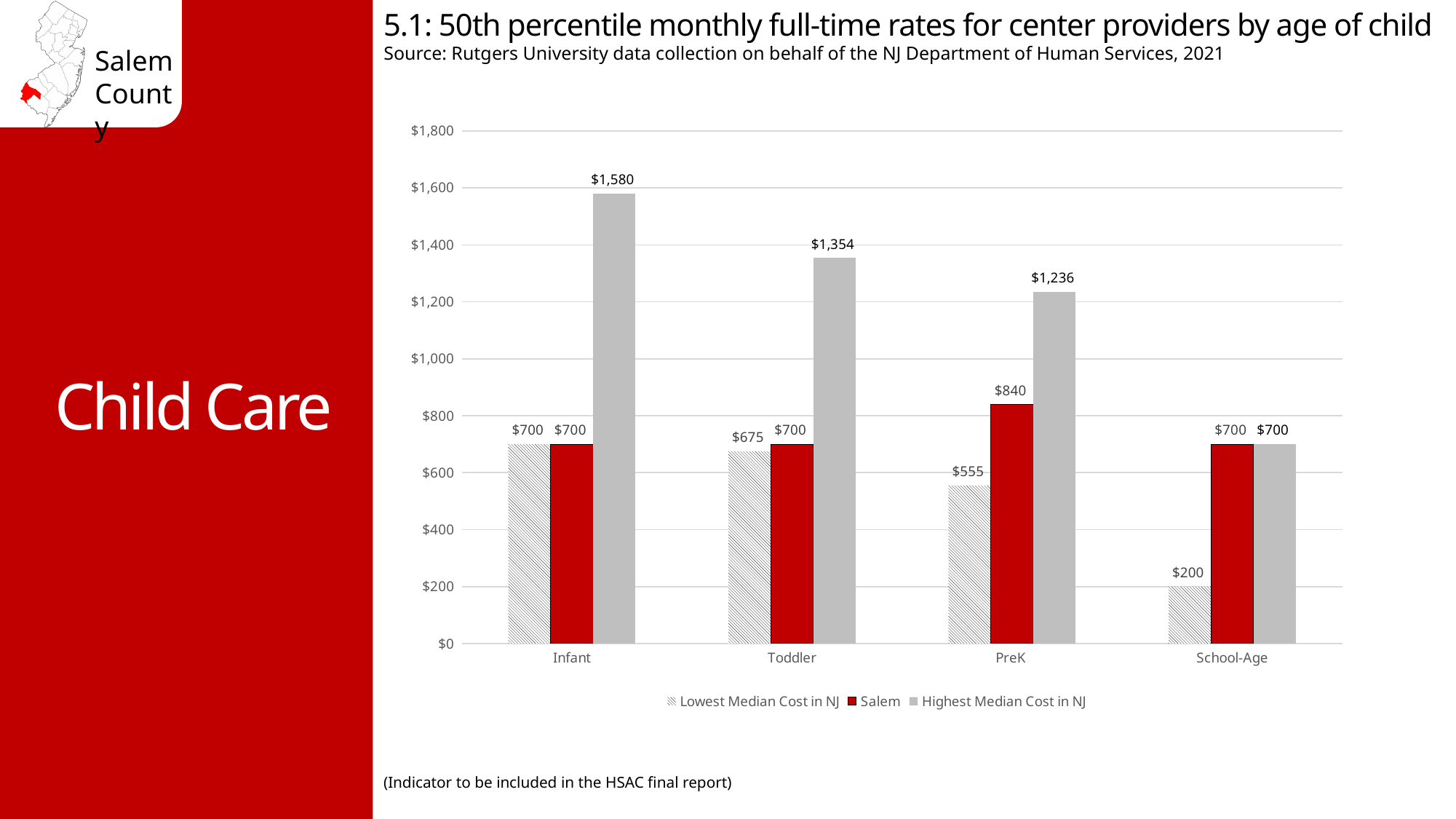
What is the Lowest Median Cost in NJ for School-Age? $200 What kind of chart is shown? bar chart How many age groups are shown on the x axis? 4 How many series does the legend list? 3 Does the Highest Median Cost in NJ rise or fall from Infant to School-Age? fall What is the Lowest Median Cost in NJ for Toddler? $675 Which age group has the lowest Lowest Median Cost in NJ? School-Age What is the Highest Median Cost in NJ for Infant? $1,580 Is the Salem value for PreK larger or smaller than the Salem value for Infant? larger What is the Salem value for PreK? $840 What is the difference between the Highest Median Cost in NJ and the Salem value for Toddler? $654 Which age group has the highest Highest Median Cost in NJ? Infant